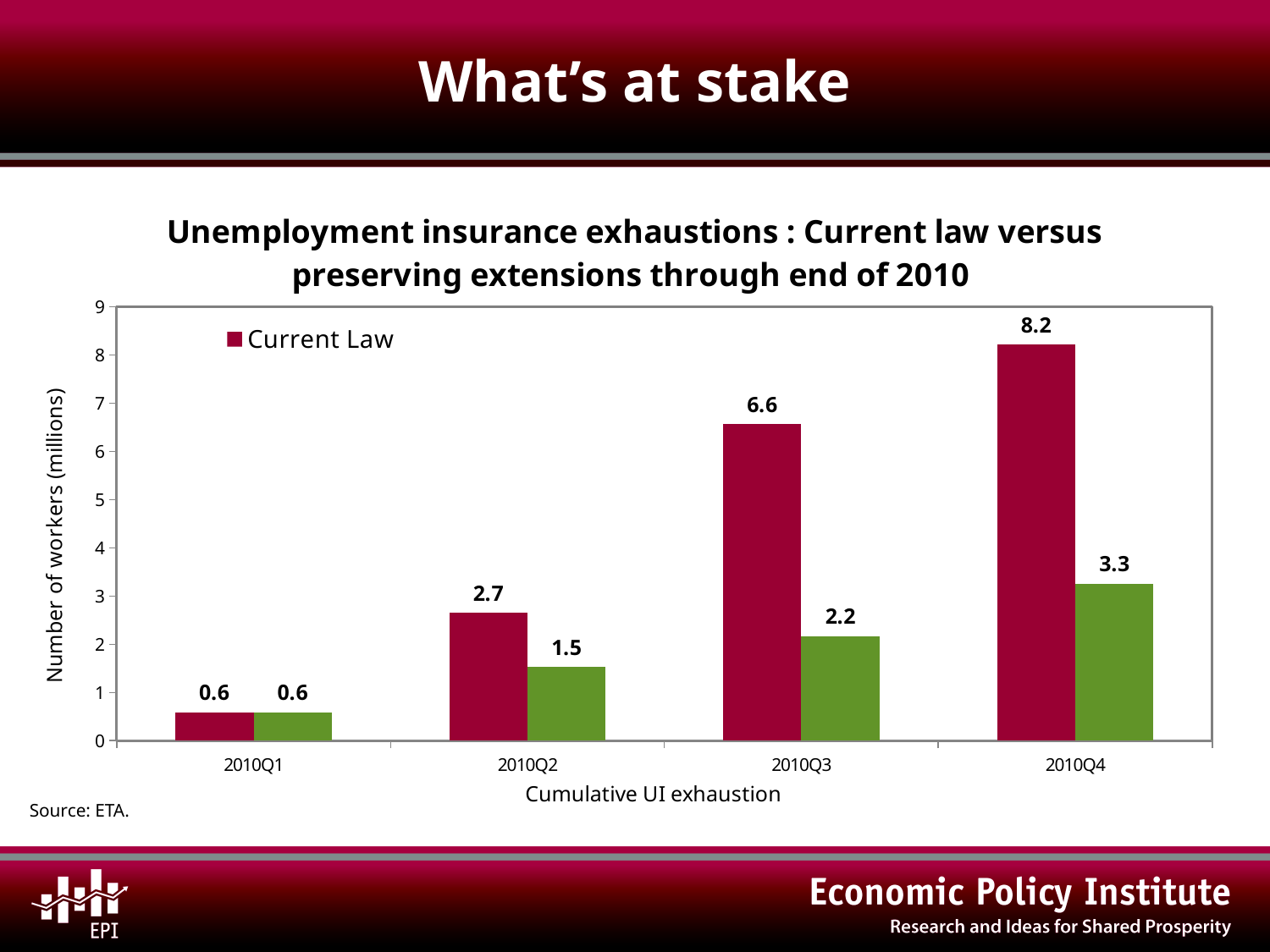
By how much does the Current Law value increase from 2010Q2 to 2010Q3? 3.9 In which quarter is the Current Law value lowest? 2010Q1 What is the difference between the Current Law bar and the green bar in 2010Q4? 4.9 How many series does the legend list? 1 In which quarter is the Current Law value highest? 2010Q4 In 2010Q3, which is larger: the Current Law bar or the green bar? Current Law How many quarters are shown on the x axis? 4 What is the Current Law value for 2010Q4? 8.2 What is the value of the green bar for 2010Q2? 1.5 What kind of chart is shown on the slide? Bar chart Do the Current Law values rise or fall from 2010Q1 to 2010Q4? Rise What is the Current Law value for 2010Q3? 6.6